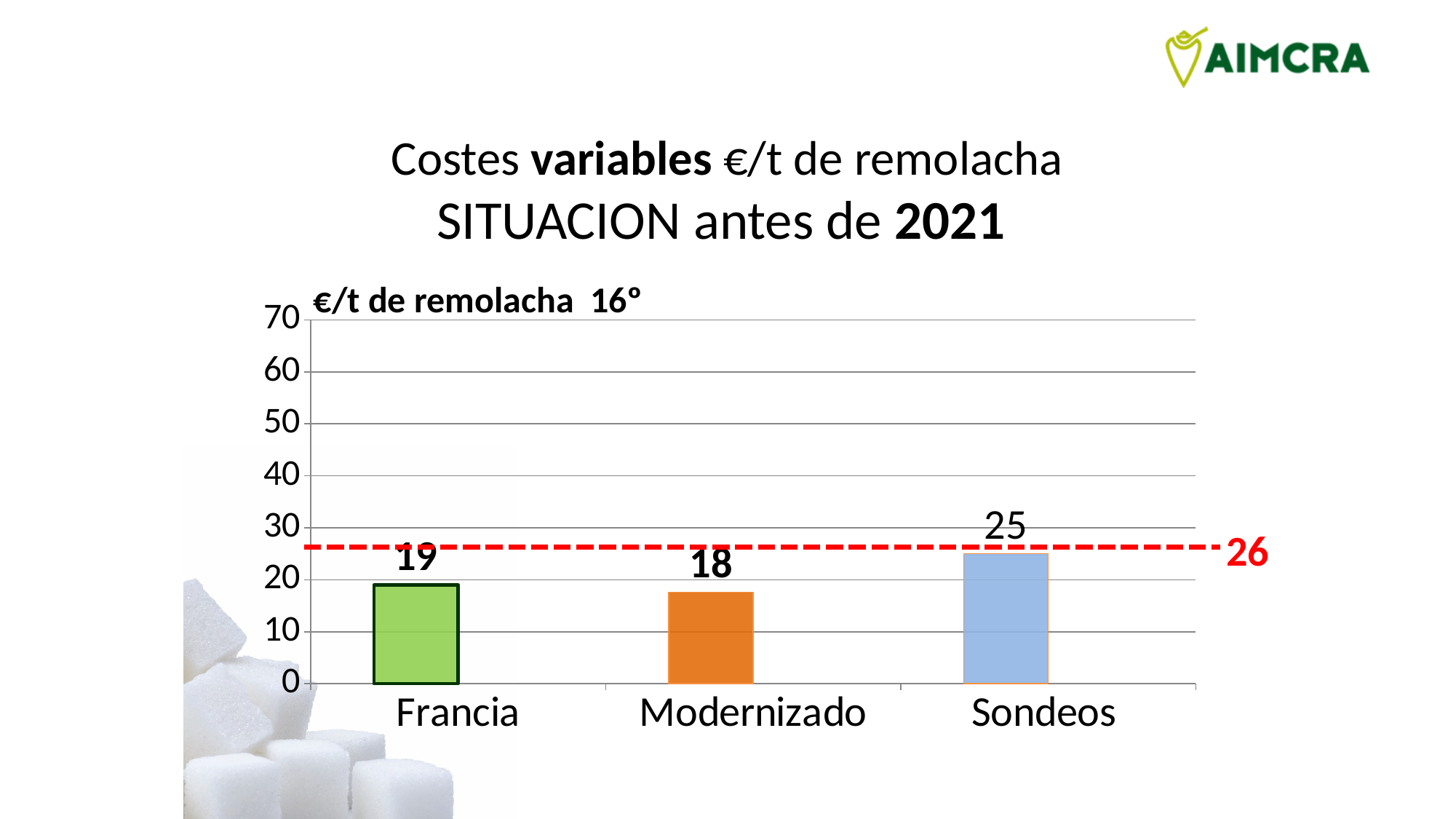
Which category has the lowest value? Modernizado What is the value for Modernizado? 18 What kind of chart is shown on the slide? bar chart What is the difference between the values for Sondeos and Francia? 6 Which is larger, the value for Sondeos or the value for Modernizado? Sondeos What is the value for Sondeos? 25 What is the difference between the values for Francia and Modernizado? 1 Is the value for Sondeos greater or less than 20? greater How many categories are shown on the x axis? 3 What is the value for Francia? 19 Which category has the highest value? Sondeos What value is labelled on the red dashed horizontal line? 26